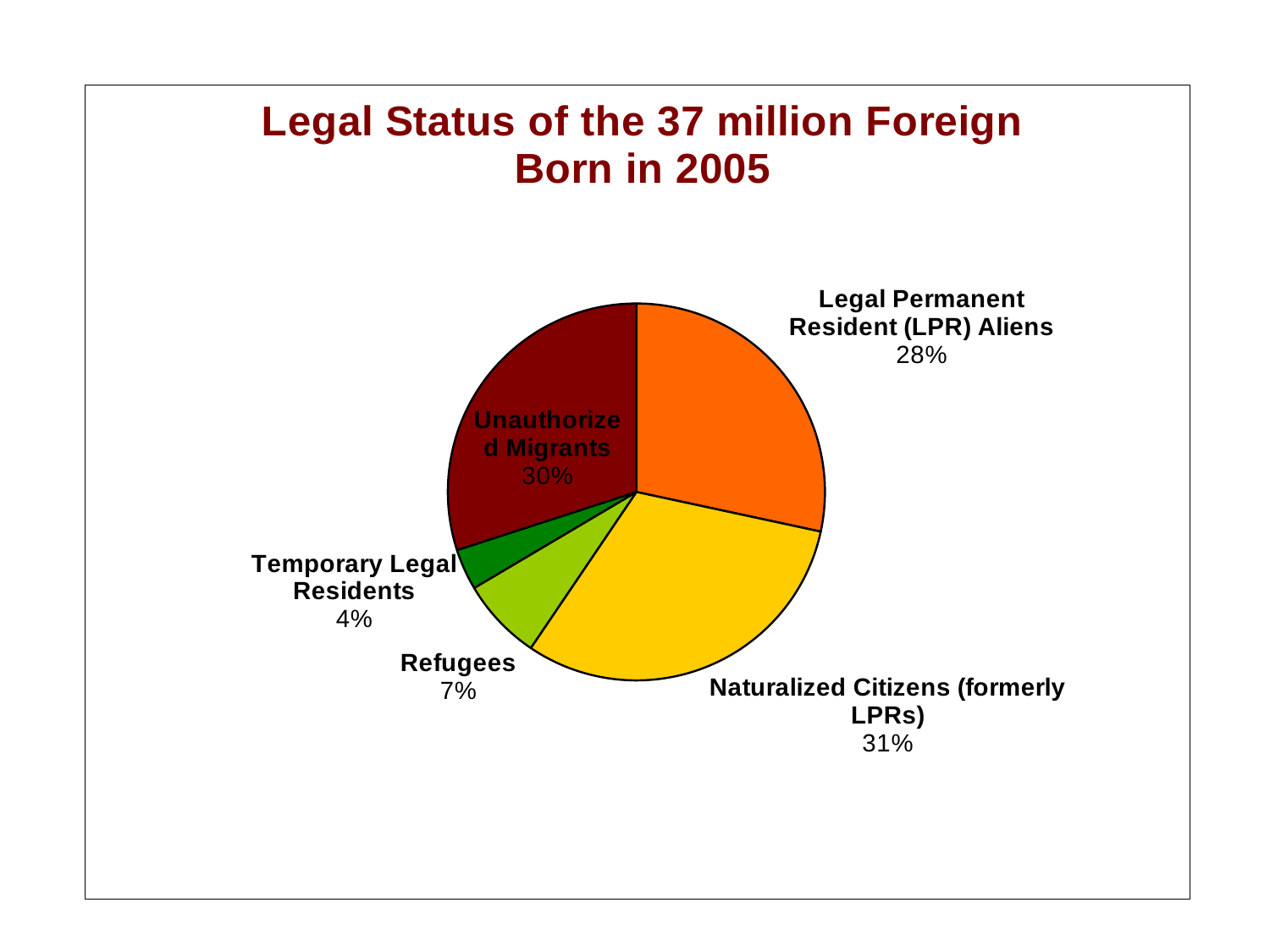
What is the title of the chart? Legal Status of the 37 million Foreign Born in 2005 What share of the pie is Unauthorized Migrants? 30% Which category has the largest slice of the pie? Naturalized Citizens (formerly LPRs) What share of the pie is Refugees? 7% What kind of chart is shown on the slide? pie chart What share of the pie is Naturalized Citizens (formerly LPRs)? 31% Which category has the smallest slice of the pie? Temporary Legal Residents What is the difference in percentage points between Unauthorized Migrants and Refugees? 23 Which is larger, the share for Refugees or the share for Temporary Legal Residents? Refugees How many categories are shown in the pie chart? 5